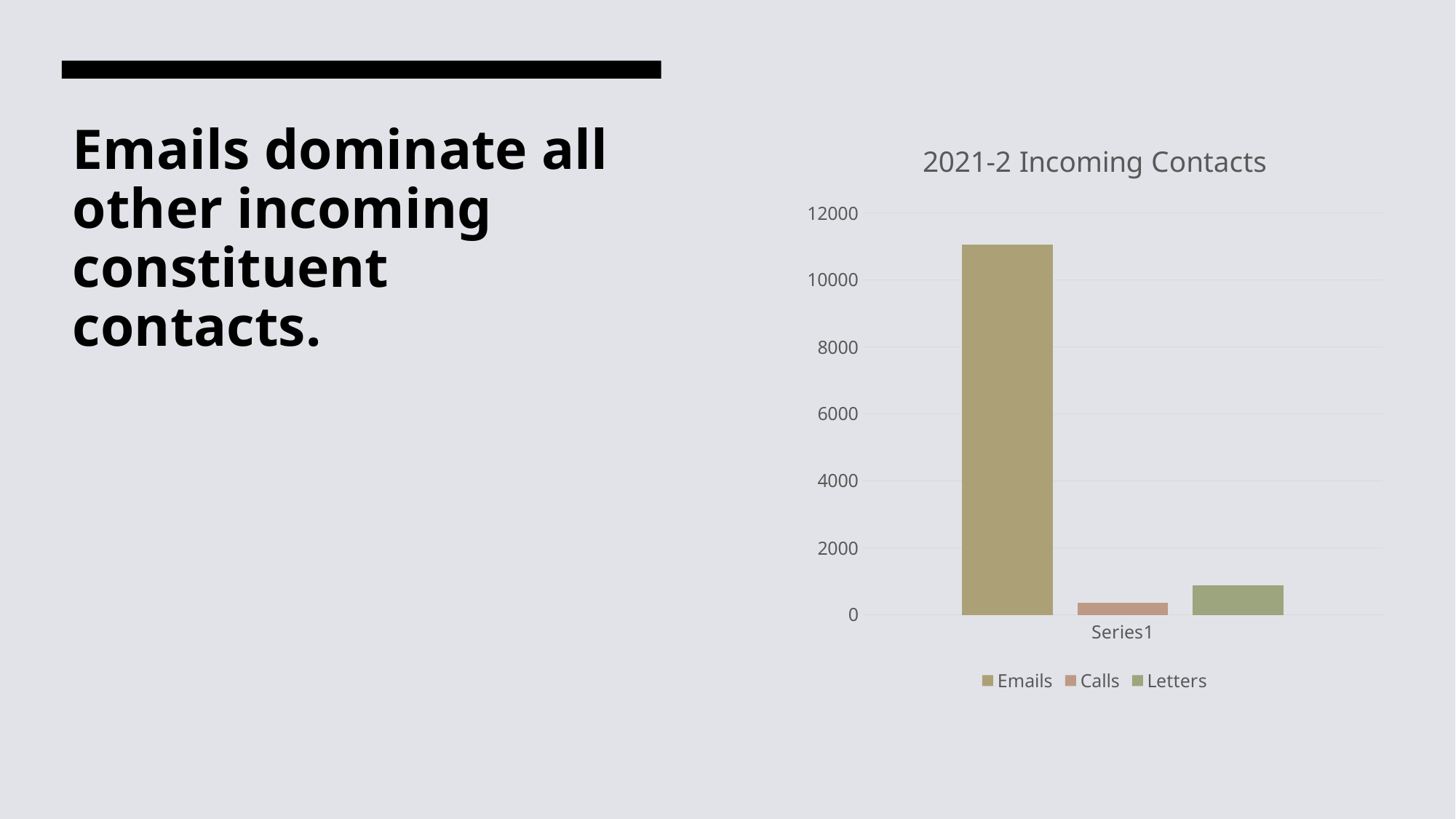
Which is larger, the value for Emails or the value for Letters? Emails What is the title of the chart? 2021-2 Incoming Contacts Is the value for Letters greater or less than 2000? less Is the value for Emails greater or less than 12000? less Which series has the lowest value in the chart? Calls Is the value for Emails greater or less than 10000? greater What kind of chart is shown on the slide? bar chart How many series does the chart legend list? 3 What are the three entries listed in the chart legend? Emails, Calls, Letters Which series has the highest value in the chart? Emails Which is larger, the value for Letters or the value for Calls? Letters